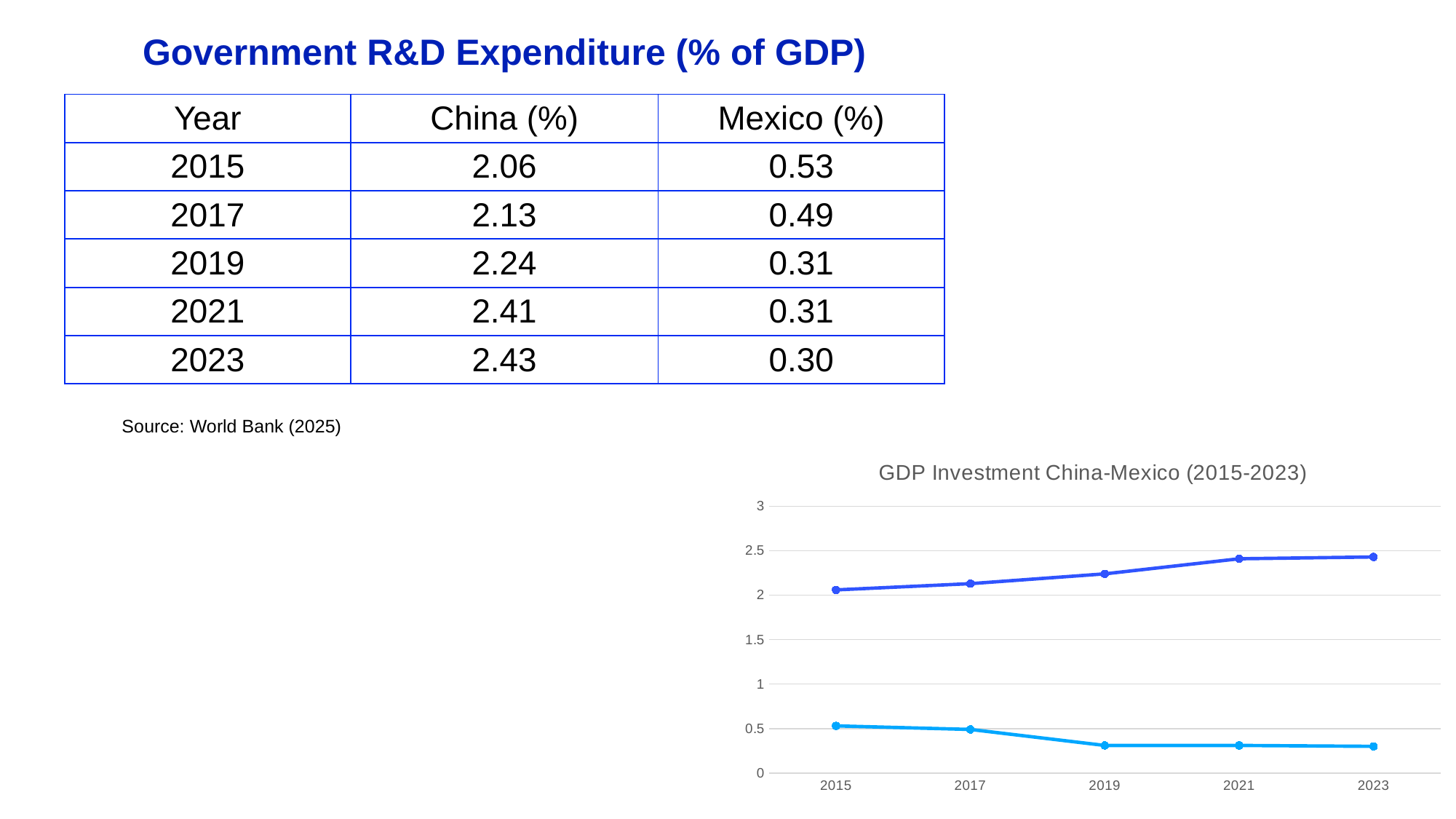
How many years are plotted along the x axis of the chart? 5 According to the table, what is the difference between China's and Mexico's R&D expenditure (% of GDP) in 2015? 1.53 According to the table, in which year was China's R&D expenditure (% of GDP) highest? 2023 According to the table, what was China's government R&D expenditure (% of GDP) in 2021? 2.41 What is the title of the chart on the slide? GDP Investment China-Mexico (2015-2023) In the chart, is the value of the lower line in 2019 greater or less than 0.5? less What kind of chart is shown on the slide? line chart According to the table, what was Mexico's government R&D expenditure (% of GDP) in 2017? 0.49 In the chart, is the value of the upper line in 2023 greater or less than 2? greater How many lines are plotted in the chart? 2 Does the upper line in the chart rise or fall from 2015 to 2023? rises Does the lower line in the chart rise or fall from 2015 to 2023? falls